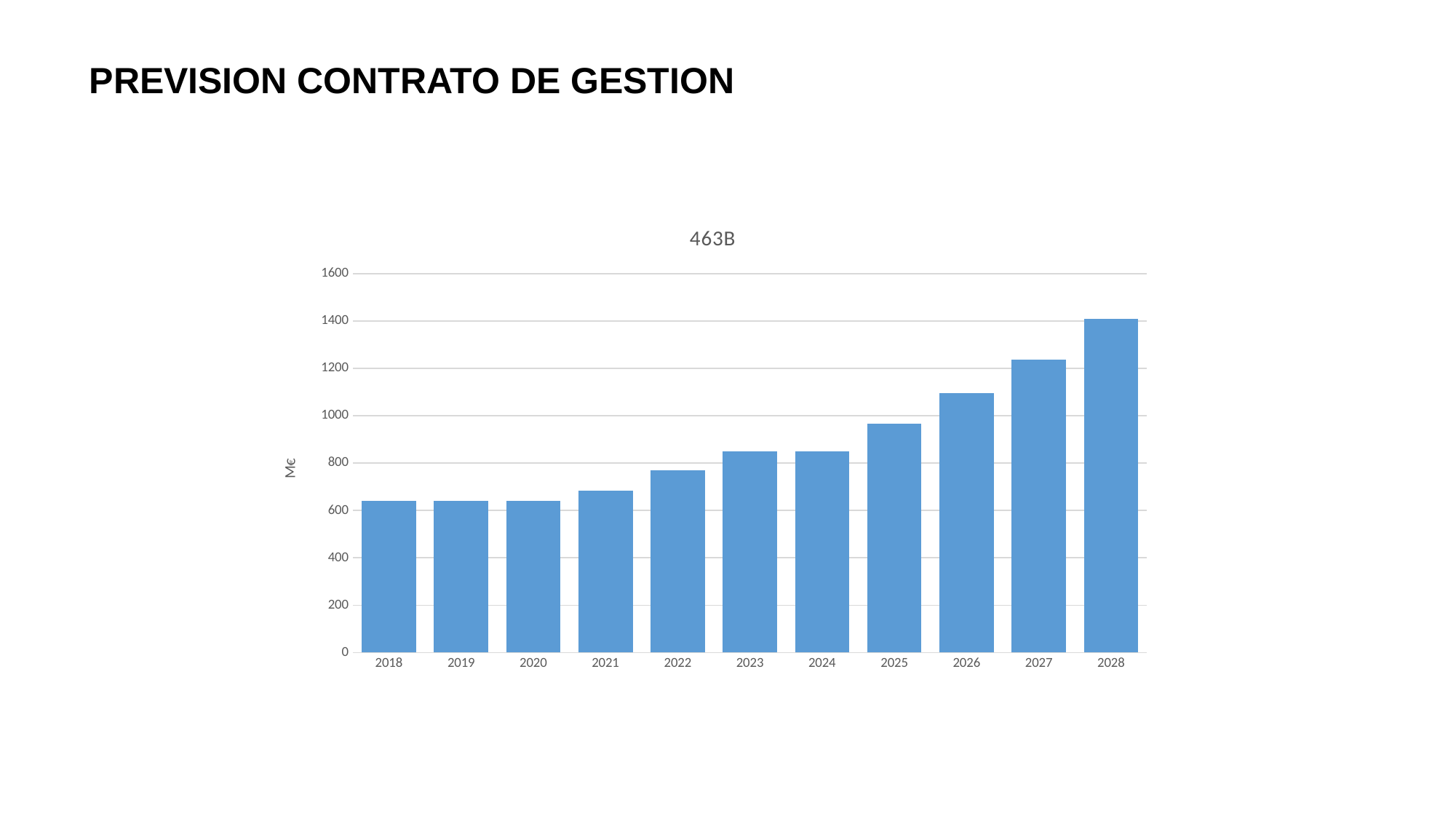
Which is larger, the value for 2026 or the value for 2022? 2026 How many years are shown on the x axis of the chart? 11 Is the value for 2028 greater or less than 1200? greater Which is larger, the value for 2019 or the value for 2025? 2025 Do the values generally rise or fall from 2018 to 2028? rise What kind of chart is shown on the slide? bar chart What label is shown on the vertical axis of the chart? M€ What is the title of the chart? 463B Is the value for 2018 greater or less than 600? greater Is the value for 2021 greater or less than 800? less Which year has the highest bar in the chart? 2028